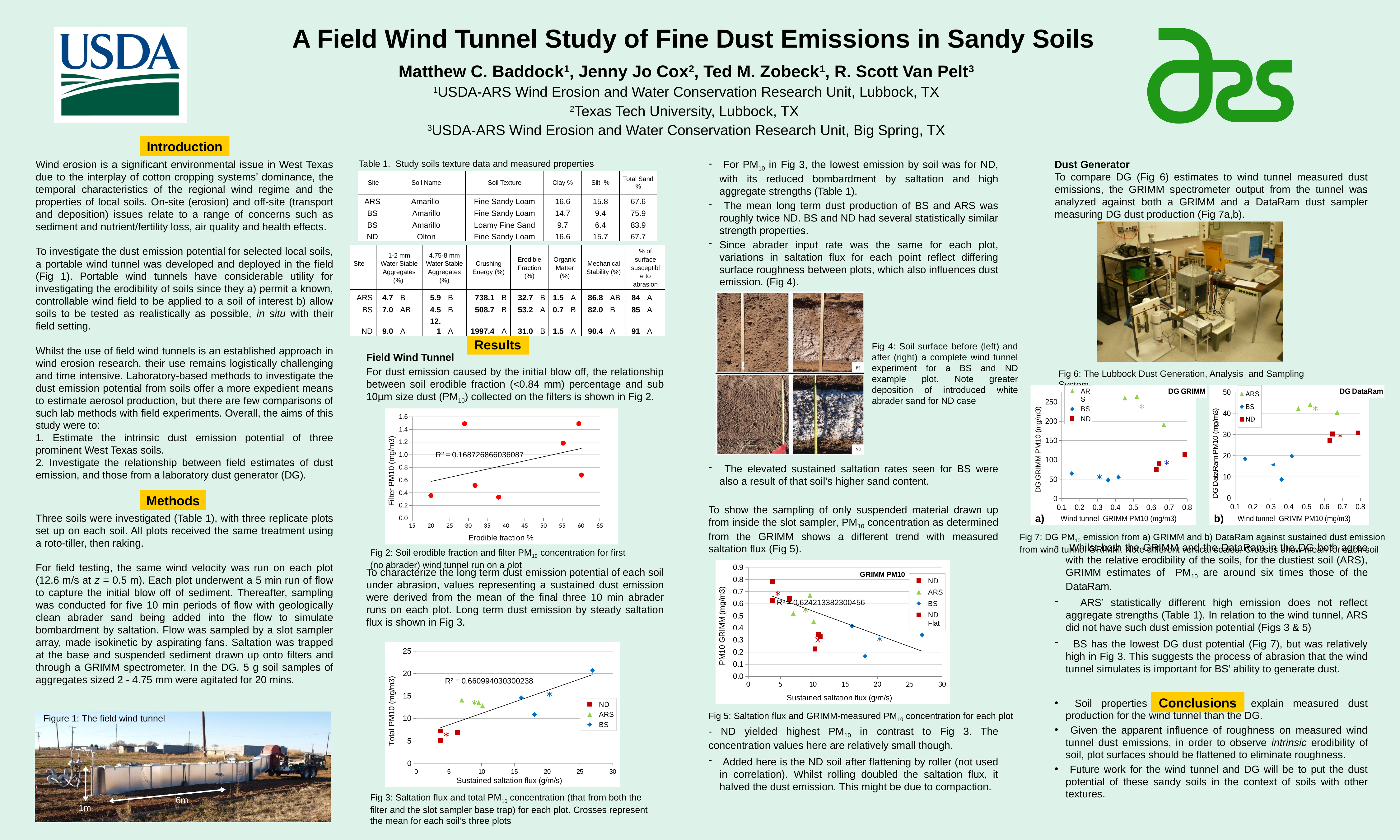
In Fig 5 (GRIMM PM10), how many entries does the legend list? 4 In Fig 7b (DG DataRam), are the BS DG DataRam PM10 values greater or less than 30 mg/m3? less In Fig 5, is the highest ND PM10 GRIMM value greater or less than 0.7 mg/m3? greater In Fig 2, what R² value is printed on the chart? R² = 0.168726866036087 In Fig 3, what R² value is printed on the chart? R² = 0.660994030300238 What kind of chart is Fig 2 (soil erodible fraction vs filter PM10)? scatter chart In Fig 3, does the fitted trend line rise or fall as sustained saltation flux increases? rises In Fig 5, does the fitted trend line rise or fall as sustained saltation flux increases? falls In Fig 3, are the ND total PM10 values greater or less than 10 mg/m3? less In Fig 3, which soil series has the highest total PM10 point? BS In Fig 3 (saltation flux vs total PM10), how many series does the legend list? 3